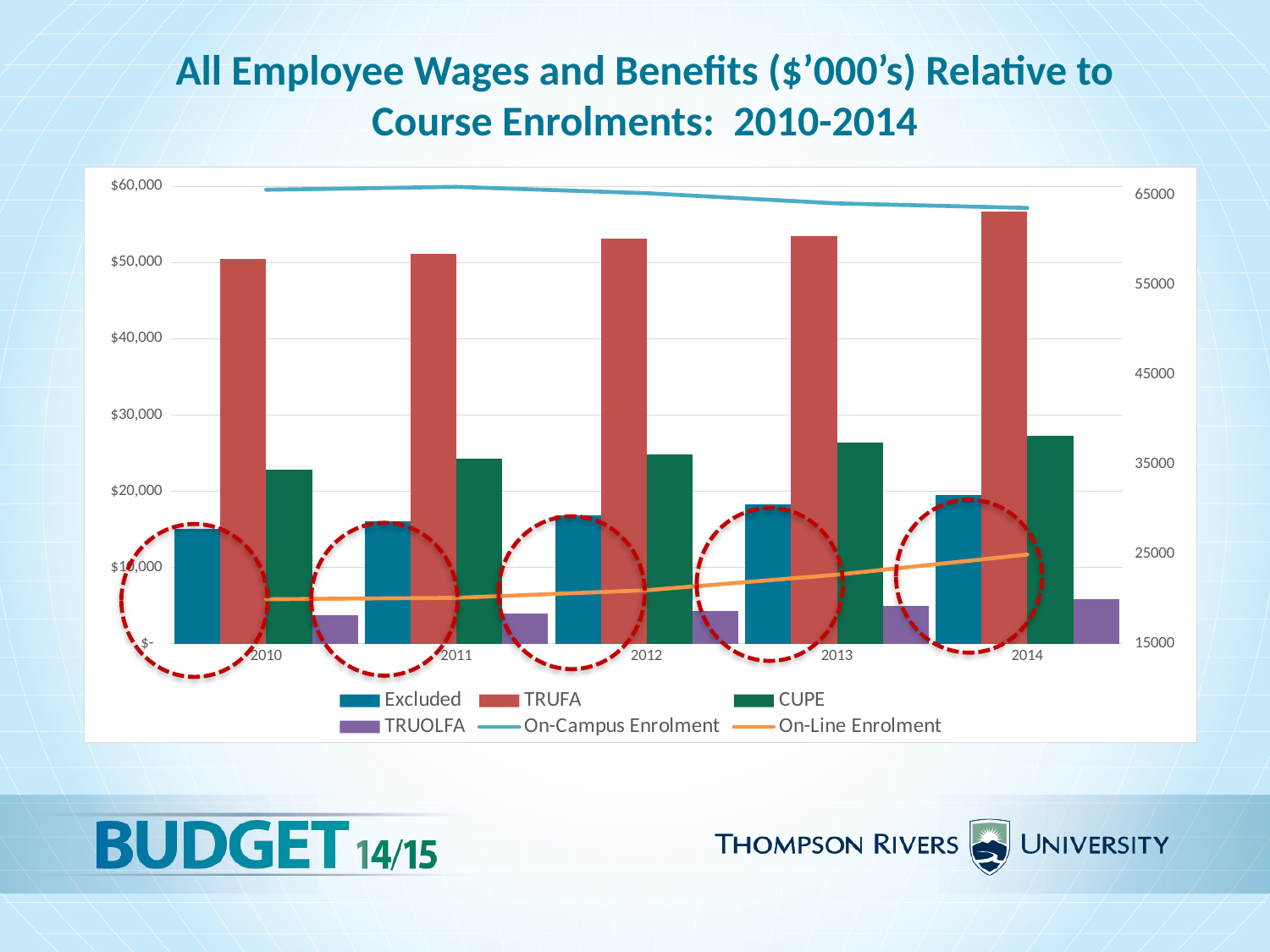
Is the Excluded value for 2014 greater or less than $10,000? greater What is the title of the chart? All Employee Wages and Benefits ($'000's) Relative to Course Enrolments: 2010-2014 Is the TRUOLFA value for 2014 greater or less than $10,000? less How many series does the legend list? 6 What kind of chart is shown on the slide? A combination bar and line chart Which employee group has the lowest bar in 2014? TRUOLFA Is the TRUFA value for 2014 greater or less than $50,000? greater How many years are shown on the x axis? 5 In which year is the TRUFA bar the highest? 2014 Does the On-Line Enrolment line rise or fall from 2010 to 2014? rises Which is larger in 2014, the CUPE bar or the Excluded bar? CUPE